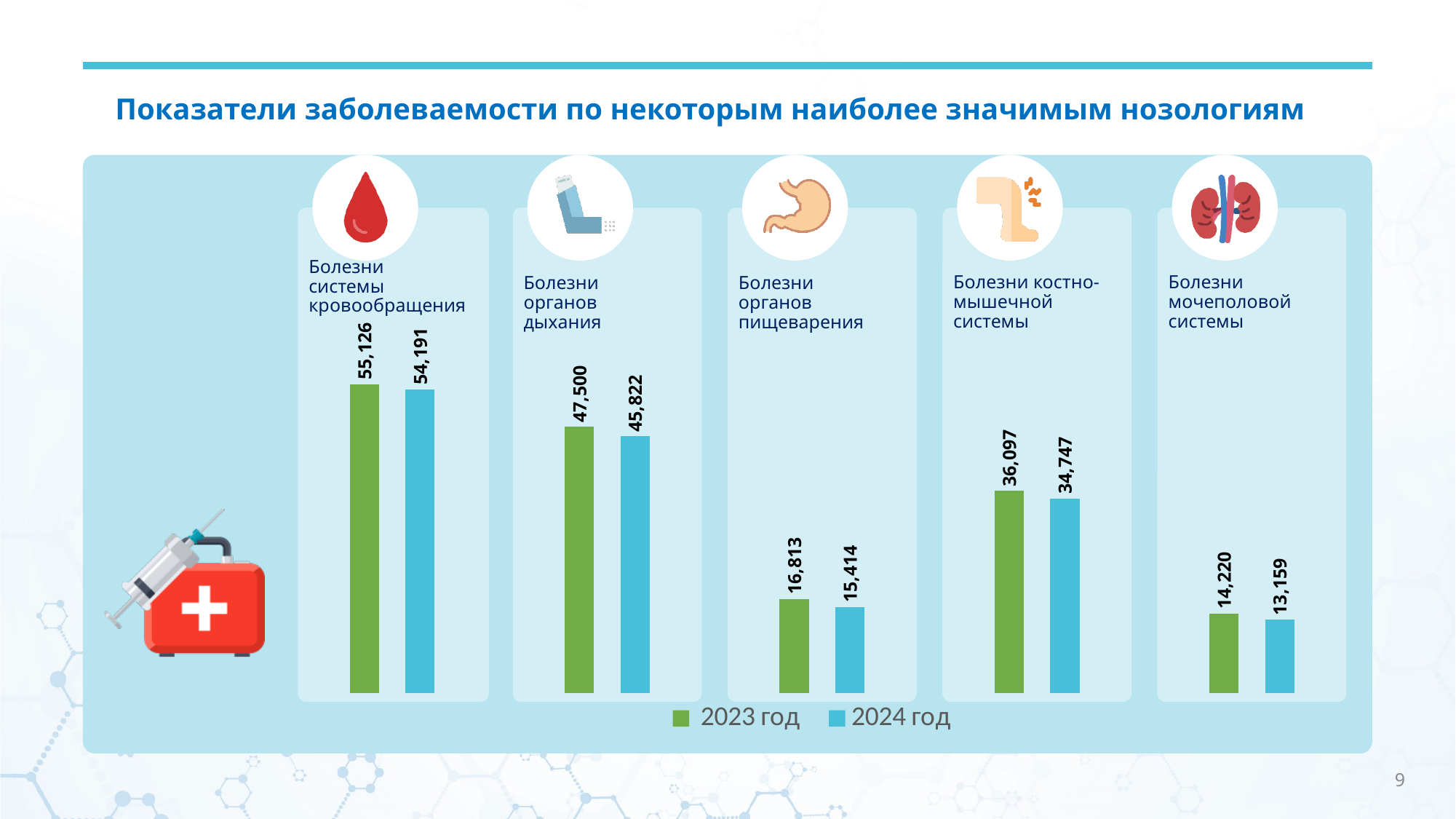
What is the 2023 value for Болезни системы кровообращения? 55,126 What is the difference between the 2023 and 2024 values for Болезни органов пищеварения? 1,399 What is the difference between the 2023 and 2024 values for Болезни органов дыхания? 1,678 What is the 2023 value for Болезни костно-мышечной системы? 36,097 Which is larger for Болезни костно-мышечной системы: the 2023 value or the 2024 value? 2023 How many series does the legend list? 2 Which category has the highest 2023 value? Болезни системы кровообращения Which category has the lowest 2024 value? Болезни мочеполовой системы What type of chart is shown on the slide? Bar chart What is the 2024 value for Болезни мочеполовой системы? 13,159 What is the 2024 value for Болезни органов дыхания? 45,822 How many disease categories are shown in the chart? 5